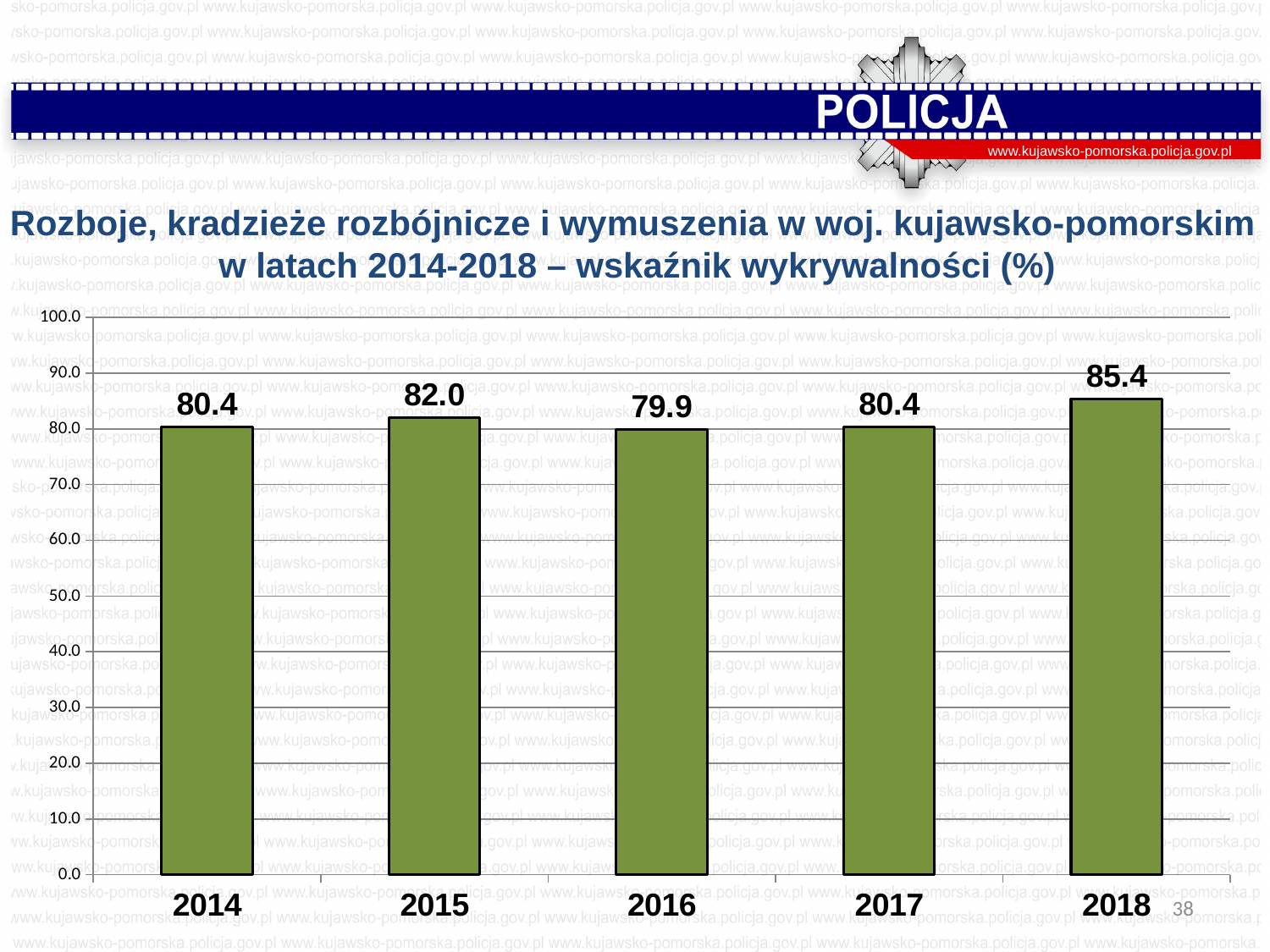
Which is larger, the value for 2015 or the value for 2017? 2015 Which year has the highest value? 2018 What is the value for 2014? 80.4 What kind of chart is shown on the slide? bar chart What is the difference between the values for 2015 and 2016? 2.1 How many years are shown on the chart? 5 What is the value for 2018? 85.4 What is the difference between the values for 2018 and 2017? 5.0 What is the value for 2015? 82.0 Which year has the lowest value? 2016 Is the value for 2018 greater or less than 80.0? greater What is the value for 2016? 79.9